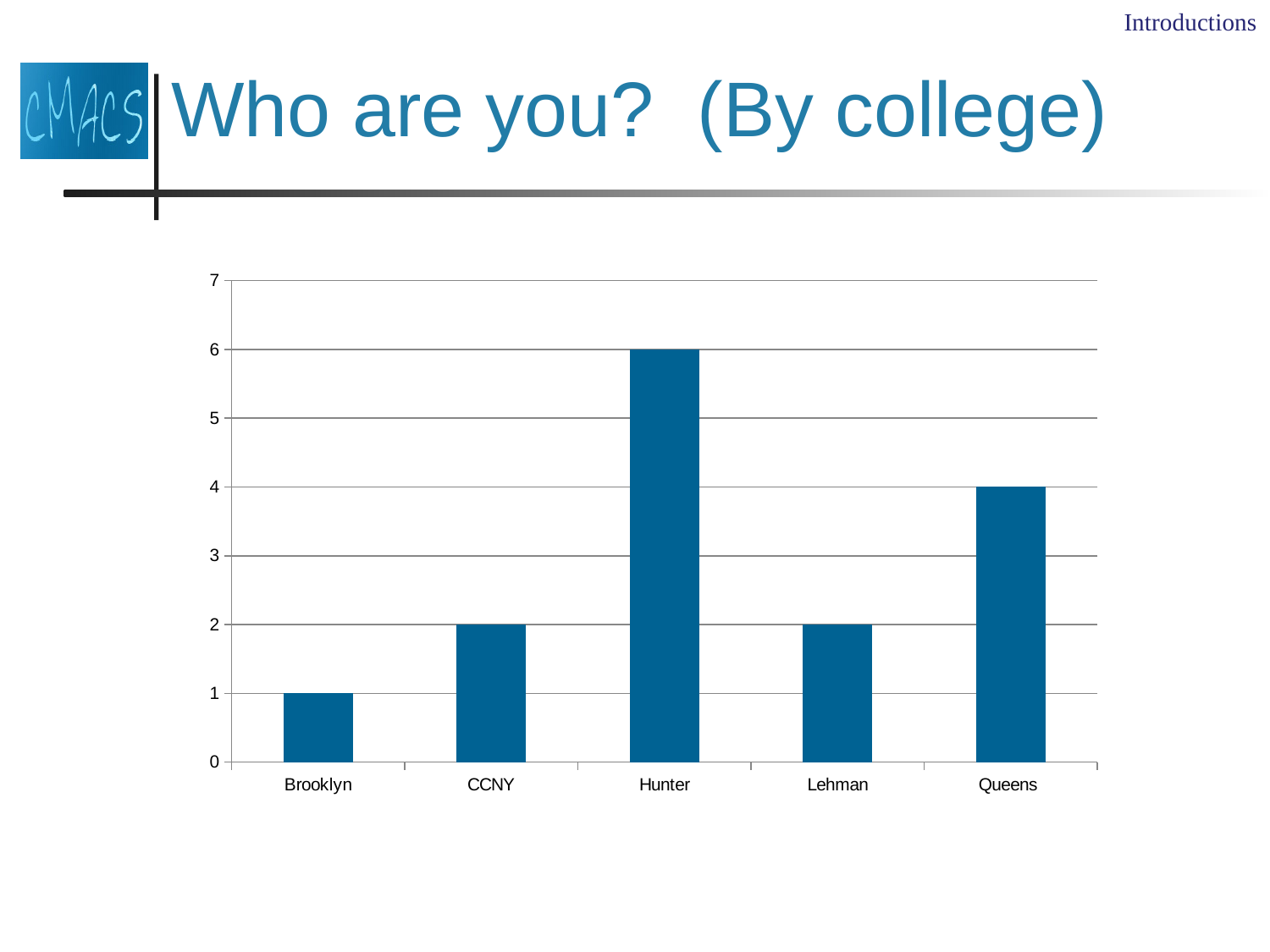
Is the value for Hunter greater or less than 5? greater Which college has the lowest bar? Brooklyn What is the value for Brooklyn? 1 How many colleges are shown on the x axis? 5 What is the value for Hunter? 6 What kind of chart is shown on the slide? bar chart What is the value for Queens? 4 What is the difference between the values for CCNY and Brooklyn? 1 Which college has the highest bar? Hunter What is the title of the slide containing the chart? Who are you? (By college) Which is larger, the value for Queens or the value for Lehman? Queens What is the difference between the values for Hunter and Queens? 2